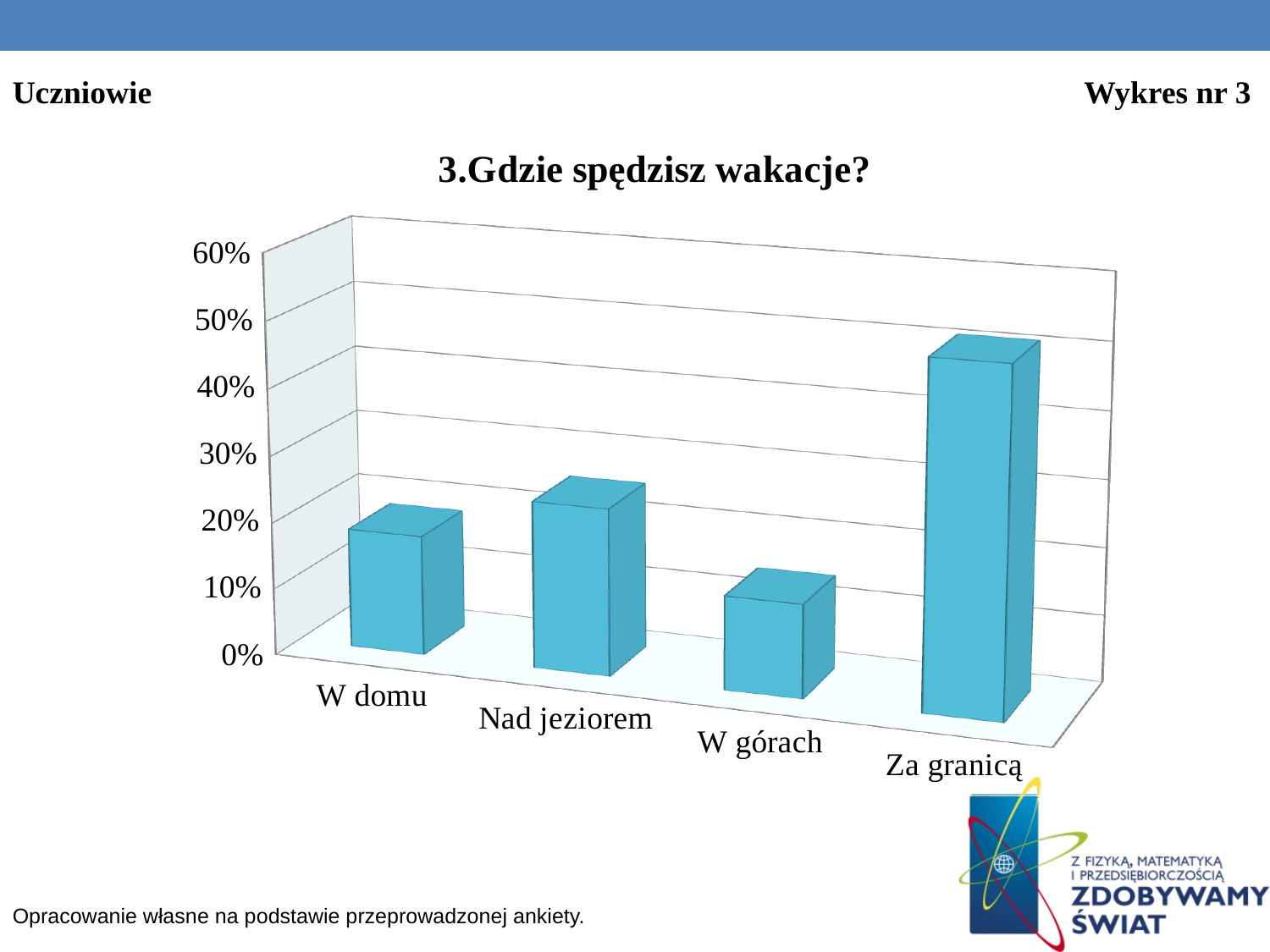
What kind of chart is shown on the slide? bar chart How many categories are shown on the chart? 4 Which is larger, the value for Nad jeziorem or the value for W domu? Nad jeziorem What is the title of the chart? 3.Gdzie spędzisz wakacje? Which is larger, the value for Za granicą or the value for W górach? Za granicą What is the highest value shown on the vertical axis? 60% Which category has the highest value? Za granicą Is the value for W domu greater or less than 30%? less Which category has the lowest value? W górach Is the value for Nad jeziorem greater or less than 10%? greater Is the value for Za granicą greater or less than 40%? greater